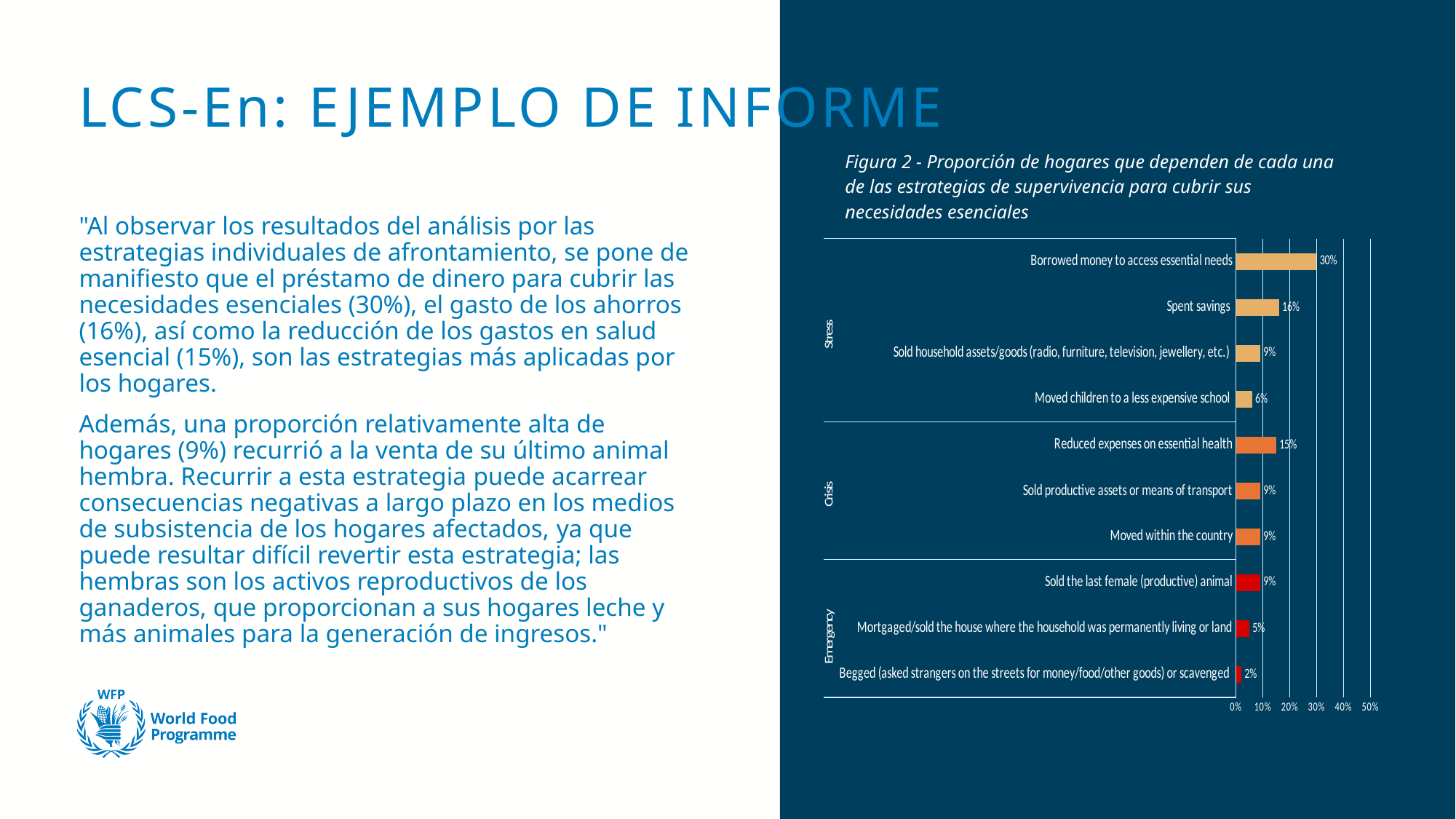
Which coping strategy has the lowest proportion of households? Begged (asked strangers on the streets for money/food/other goods) or scavenged How many coping strategies are plotted in the chart? 10 What is the value for 'Moved children to a less expensive school'? 6% What is the value for 'Begged (asked strangers on the streets for money/food/other goods) or scavenged'? 2% What is the value for 'Reduced expenses on essential health'? 15% Which is larger: 'Sold the last female (productive) animal' or 'Mortgaged/sold the house where the household was permanently living or land'? Sold the last female (productive) animal Which coping strategy has the highest proportion of households? Borrowed money to access essential needs What is the value for 'Spent savings'? 16% What are the three category groups labelled on the vertical axis of the chart? Stress, Crisis, Emergency What is the difference between 'Borrowed money to access essential needs' and 'Spent savings'? 14% What kind of chart is shown on the slide? Bar chart What is the value for 'Borrowed money to access essential needs'? 30%